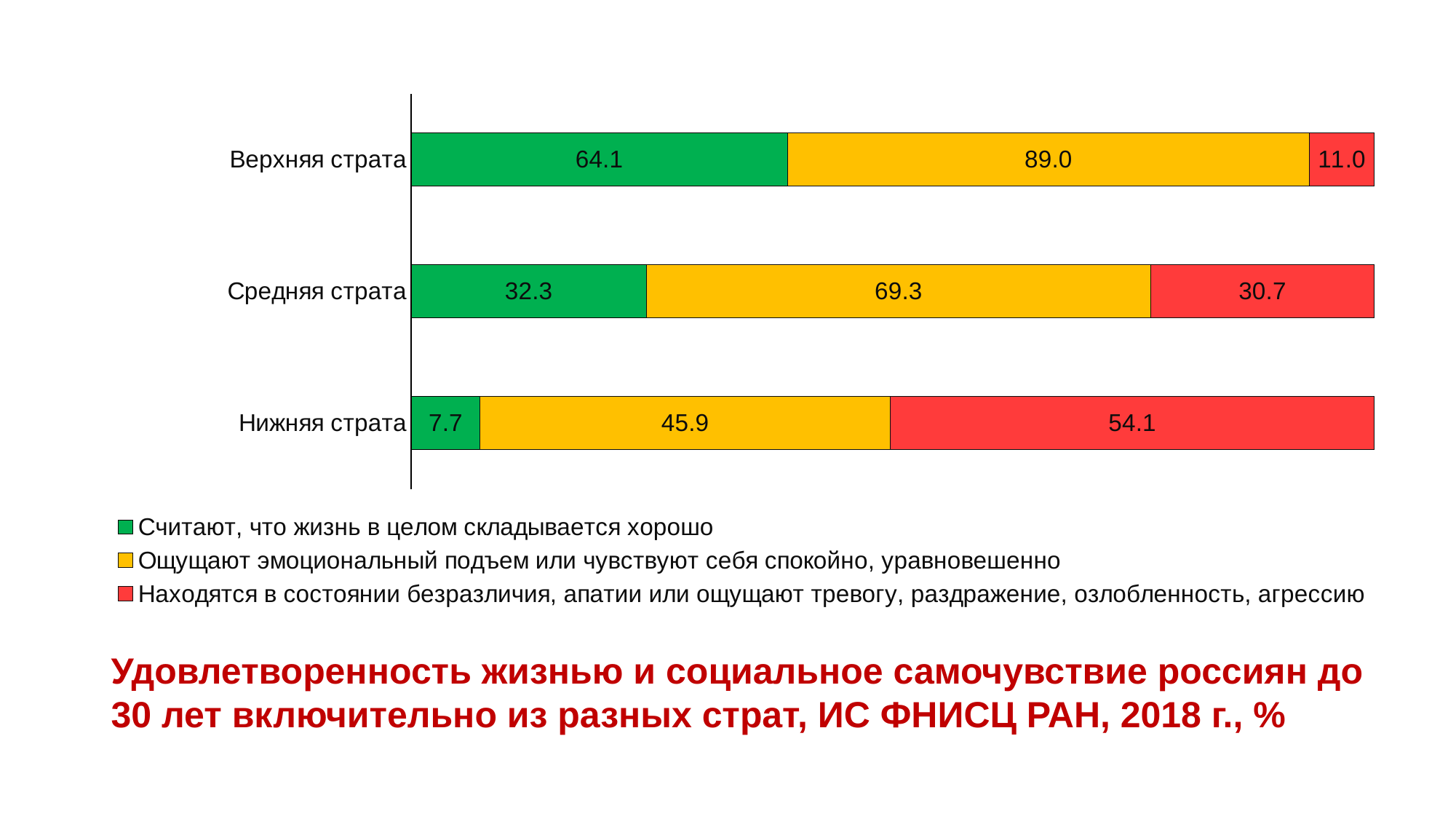
How many series does the legend list? 3 Which stratum has the highest value in the series "Считают, что жизнь в целом складывается хорошо"? Верхняя страта Which stratum has the lowest value in the series "Находятся в состоянии безразличия, апатии или ощущают тревогу, раздражение, озлобленность, агрессию"? Верхняя страта Which colour represents the series "Находятся в состоянии безразличия, апатии или ощущают тревогу, раздражение, озлобленность, агрессию"? Red What is the value for "Верхняя страта" in the series "Считают, что жизнь в целом складывается хорошо"? 64.1 What is the value for "Нижняя страта" in the series "Находятся в состоянии безразличия, апатии или ощущают тревогу, раздражение, озлобленность, агрессию"? 54.1 What is the difference between the values for "Нижняя страта" and "Средняя страта" in the series "Находятся в состоянии безразличия, апатии или ощущают тревогу, раздражение, озлобленность, агрессию"? 23.4 Which is larger: the value for "Средняя страта" or "Нижняя страта" in the series "Ощущают эмоциональный подъем или чувствуют себя спокойно, уравновешенно"? Средняя страта What kind of chart is shown on the slide? Stacked bar chart What is the difference between the values for "Верхняя страта" and "Нижняя страта" in the series "Считают, что жизнь в целом складывается хорошо"? 56.4 How many strata (categories) are shown on the chart? 3 What is the value for "Средняя страта" in the series "Ощущают эмоциональный подъем или чувствуют себя спокойно, уравновешенно"? 69.3